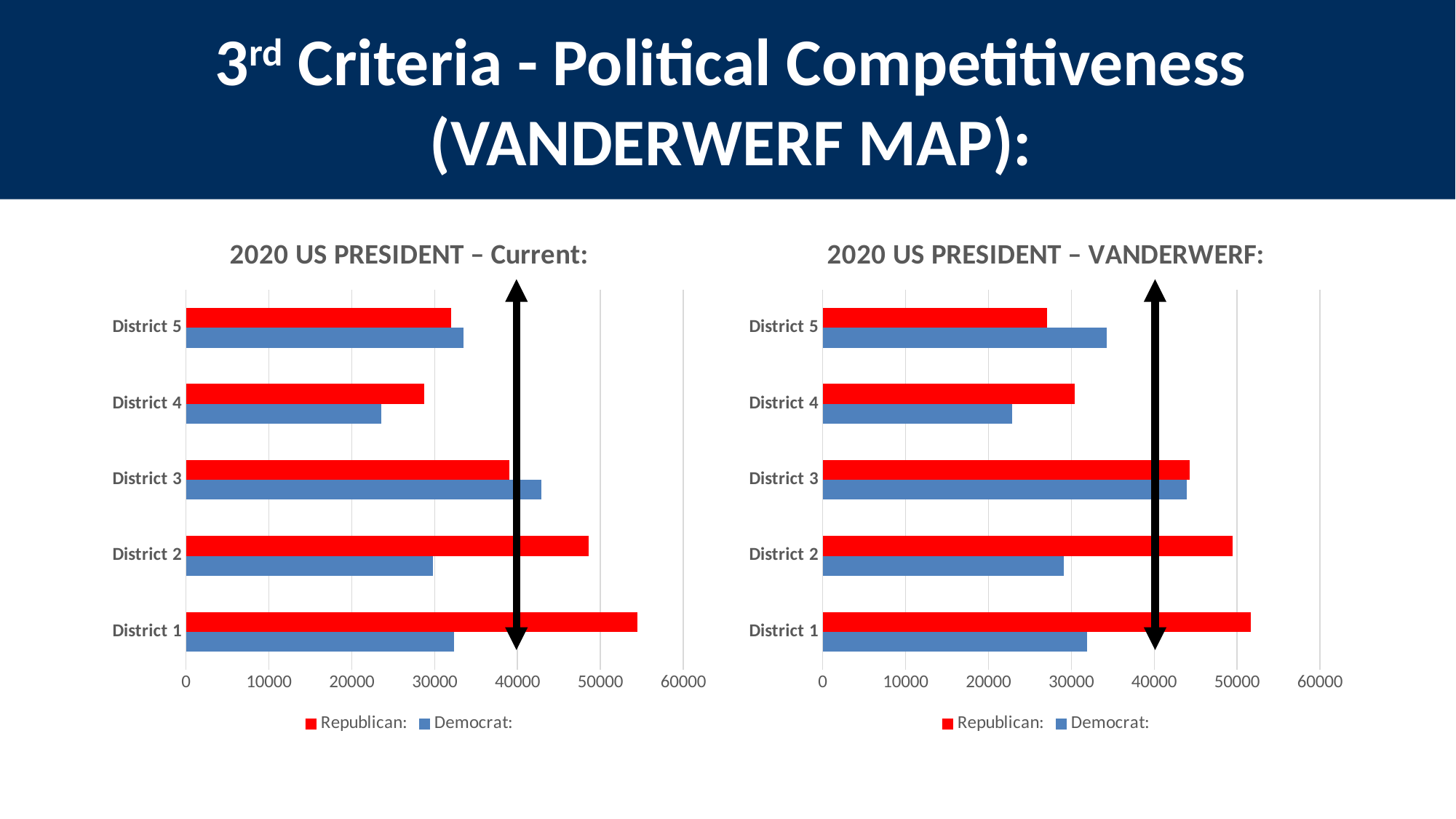
On the chart titled '2020 US PRESIDENT – Current:', what kind of chart is shown? bar chart On the chart titled '2020 US PRESIDENT – Current:', how many districts are plotted? 5 On the chart titled '2020 US PRESIDENT – VANDERWERF:', which is larger for District 5, the Republican value or the Democrat value? Democrat On the chart titled '2020 US PRESIDENT – VANDERWERF:', what colour represents the Republican series? red On the chart titled '2020 US PRESIDENT – VANDERWERF:', is the Democrat value for District 4 greater or less than 30000? less On the chart titled '2020 US PRESIDENT – Current:', is the Republican value for District 1 greater or less than 50000? greater On the chart titled '2020 US PRESIDENT – VANDERWERF:', which district has the highest Democrat value? District 3 On the chart titled '2020 US PRESIDENT – Current:', how many series does the legend list? 2 On the chart titled '2020 US PRESIDENT – VANDERWERF:', is the Republican value for District 5 greater or less than 30000? less On the chart titled '2020 US PRESIDENT – Current:', which is larger for District 2, the Republican value or the Democrat value? Republican On the chart titled '2020 US PRESIDENT – Current:', which district has the highest Republican value? District 1 On the chart titled '2020 US PRESIDENT – Current:', which district has the lowest Democrat value? District 4